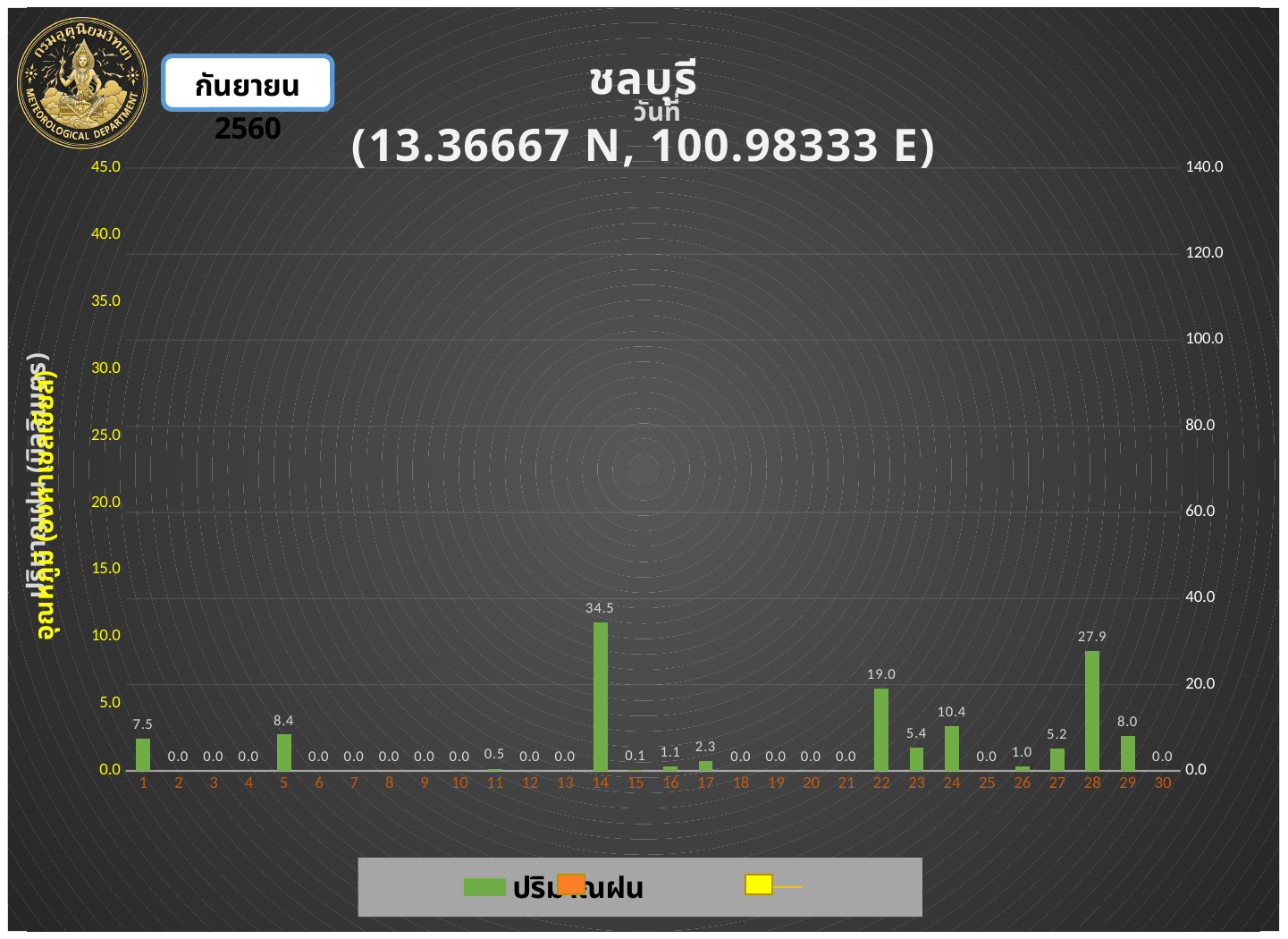
Which has a larger rainfall value, day 23 or day 27? day 23 Which has a larger rainfall value, day 1 or day 29? day 29 What is the rainfall value for day 5? 8.4 Which day has the highest rainfall value? 14 What is the name of the station shown in the chart title? ชลบุรี What is the rainfall value for day 14? 34.5 How many days are shown on the x axis? 30 What is the difference between the rainfall values for day 14 and day 28? 6.6 What is the rainfall value for day 28? 27.9 What is the difference between the rainfall values for day 22 and day 24? 8.6 What kind of chart is shown on the slide? bar chart What is the rainfall value for day 22? 19.0